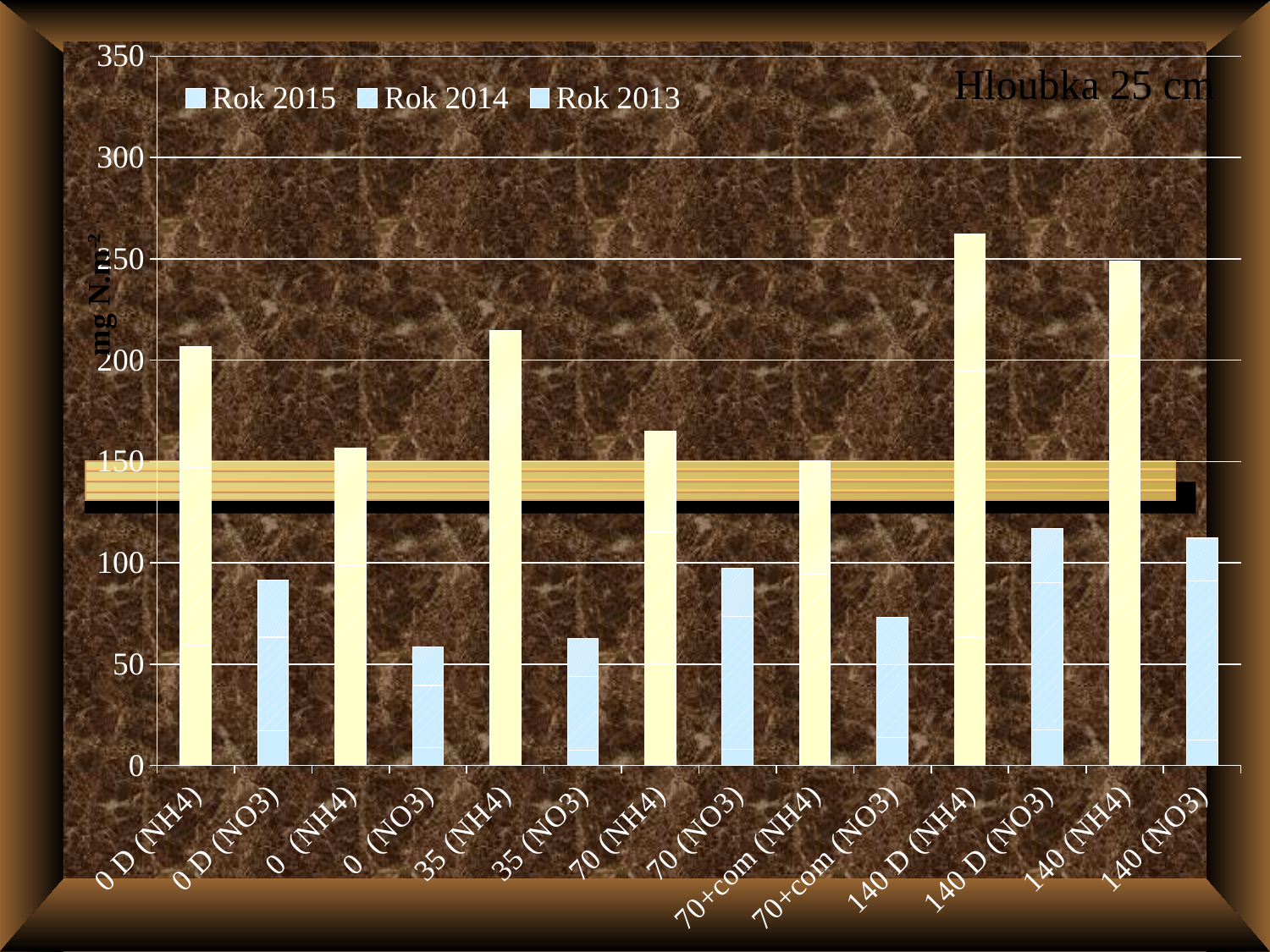
How many series does the legend list? 3 Is the total value for 140 D (NH4) greater or less than 250? greater What is the title shown on the chart? Hloubka 25 cm Is the total value for 0 D (NH4) greater or less than 200? greater Is the total value for 70+com (NO3) greater or less than 100? less Which has the larger total bar, 140 D (NO3) or 70 (NO3)? 140 D (NO3) What kind of chart is shown on the slide? bar chart Which category has the highest total bar? 140 D (NH4) How many categories are shown on the x axis? 14 Which has the larger total bar, 0 D (NH4) or 0 (NH4)? 0 D (NH4)